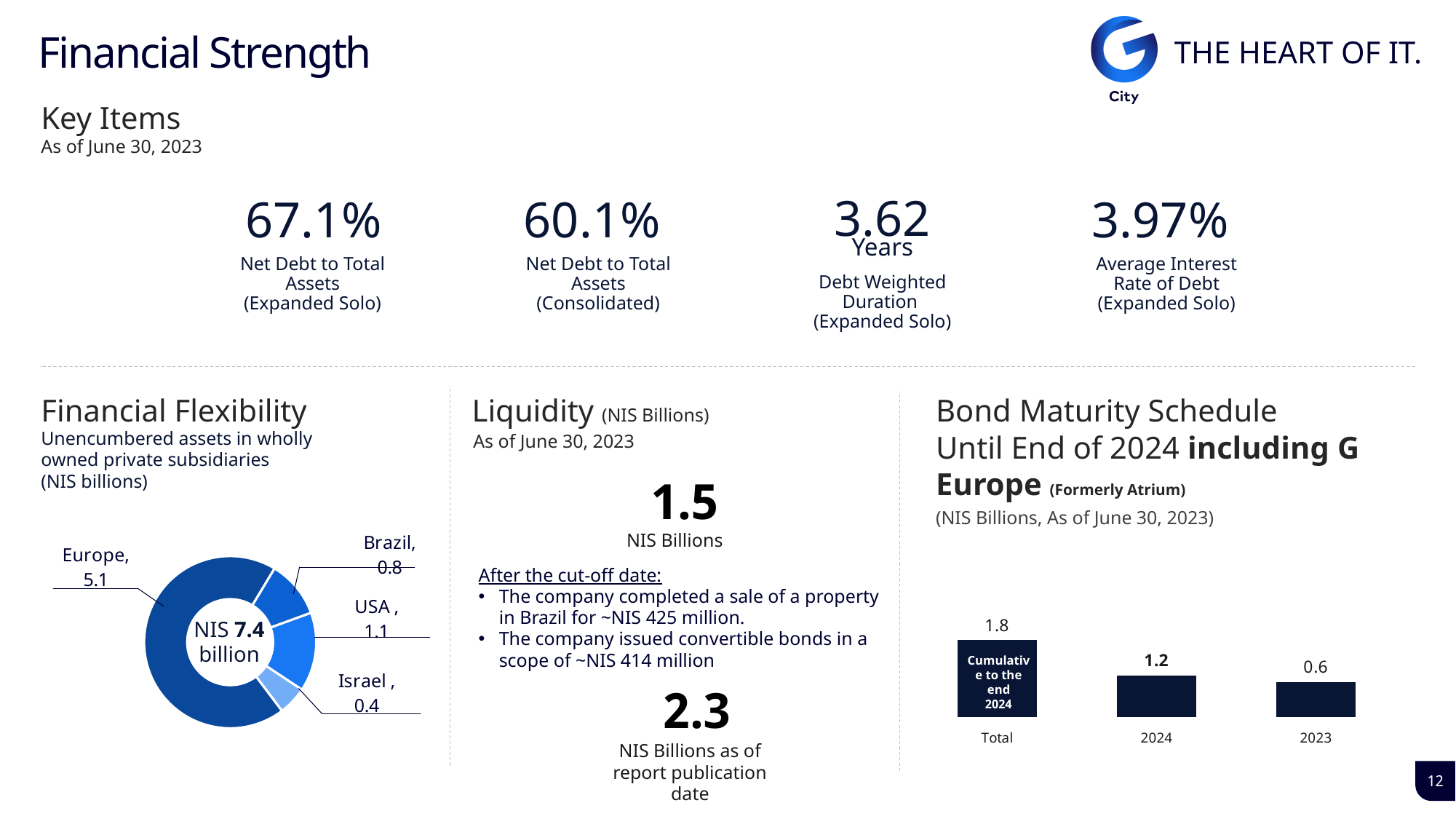
In the Financial Flexibility donut chart, how many regions are shown? 4 In the Financial Flexibility donut chart, what is the difference between the USA and Brazil values? 0.3 In the Bond Maturity Schedule chart, what is the value for 2023? 0.6 In the Bond Maturity Schedule chart, what is the value for 2024? 1.2 In the Financial Flexibility donut chart, which region has the smallest value? Israel In the Financial Flexibility donut chart, what is the value for Israel? 0.4 In the Financial Flexibility donut chart, what is the value for Europe? 5.1 In the Bond Maturity Schedule chart, what is the difference between the 2024 and 2023 values? 0.6 In the Bond Maturity Schedule chart, which is larger, the value for 2024 or the value for 2023? 2024 In the Financial Flexibility donut chart, what total is shown in the centre of the donut? NIS 7.4 billion In the Financial Flexibility donut chart, which region has the largest value? Europe What kind of chart is the Bond Maturity Schedule chart? Bar chart